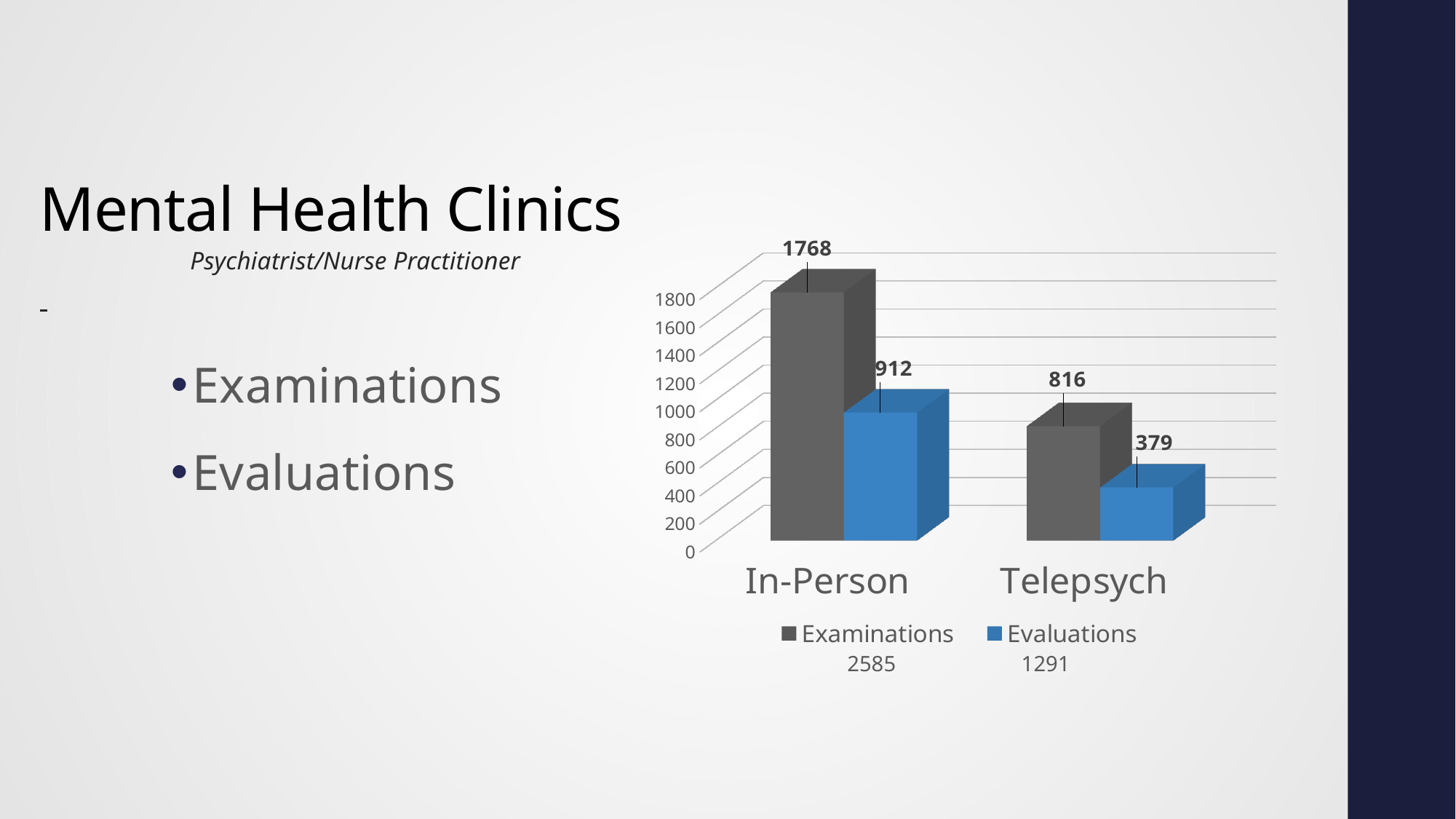
What is the value for Evaluations in the Telepsych category? 379 How many series does the legend list? 2 What is the value for Examinations in the Telepsych category? 816 What is the value for Evaluations in the In-Person category? 912 Which category has the lowest Evaluations value? Telepsych Which category has the highest Examinations value? In-Person What is the value for Examinations in the In-Person category? 1768 Which is larger: Evaluations for In-Person or Examinations for Telepsych? Evaluations for In-Person How many categories are shown on the x axis? 2 What is the difference between the Examinations values for In-Person and Telepsych? 952 What is the difference between Examinations and Evaluations for In-Person? 856 What kind of chart is shown on the slide? Bar chart